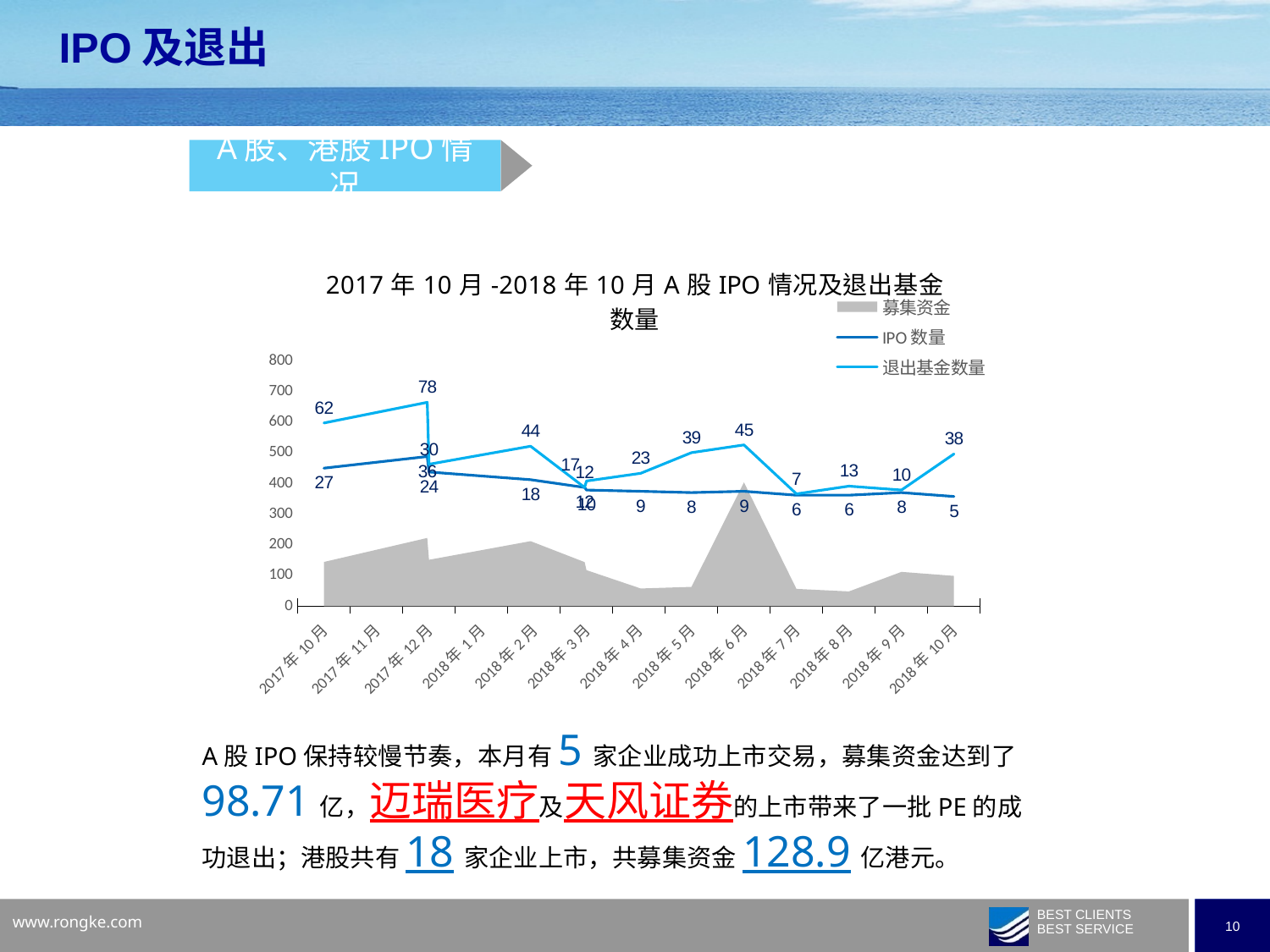
In which month is the IPO数量 value lowest? 2018年10月 What is the 退出基金数量 value for 2018年6月? 45 Which month has the larger 退出基金数量 value, 2018年6月 or 2018年7月? 2018年6月 What is the highest 退出基金数量 value shown on the chart? 78 What kind of chart is shown on the slide? combination area and line chart How many months are shown on the x axis? 13 Is the 募集资金 value for 2018年6月 greater or less than 300? greater What is the 退出基金数量 value for 2017年10月? 62 What is the difference between the 退出基金数量 values for 2018年6月 and 2018年7月? 38 What is the IPO数量 value for 2017年10月? 27 How many series does the legend list? 3 What is the IPO数量 value for 2018年10月? 5